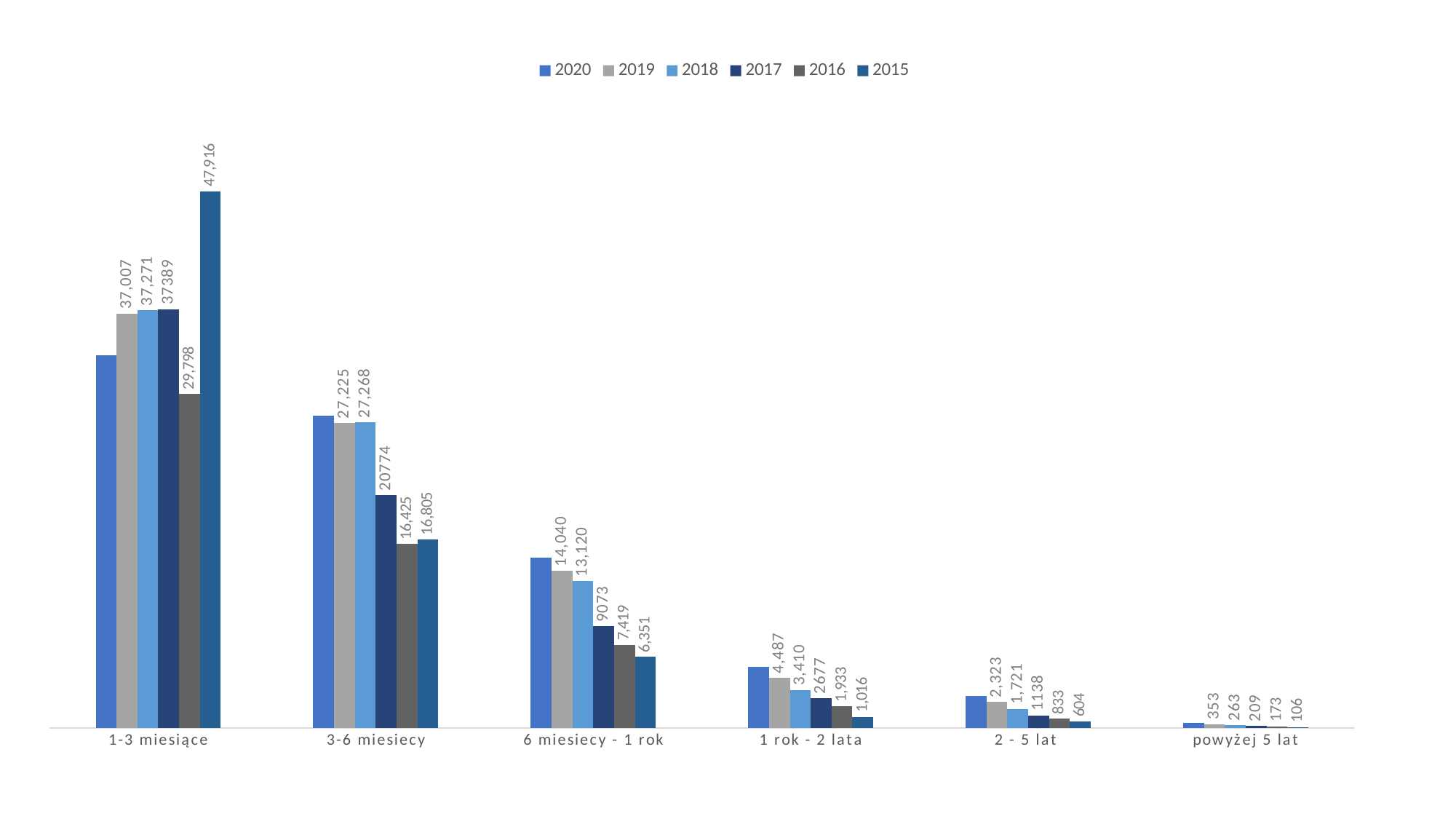
What is the value for 2016 in the 3-6 miesiecy category? 16,425 What is the value for 2015 in the 1-3 miesiące category? 47,916 What is the value for 2019 in the 6 miesiecy - 1 rok category? 14,040 Which category has the lowest value for 2015? powyżej 5 lat Which series has the highest value in the 1-3 miesiące category? 2015 Do the 2019 values rise or fall moving from 1-3 miesiące to powyżej 5 lat along the x axis? fall What type of chart is shown on the slide? bar chart What is the difference between the 2019 and 2015 values in the 1 rok - 2 lata category? 3,471 Which is larger in the 6 miesiecy - 1 rok category: the 2016 value or the 2015 value? 2016 How many series does the legend list? 6 What is the value for 2017 in the 2 - 5 lat category? 1138 How many categories are shown on the x axis? 6